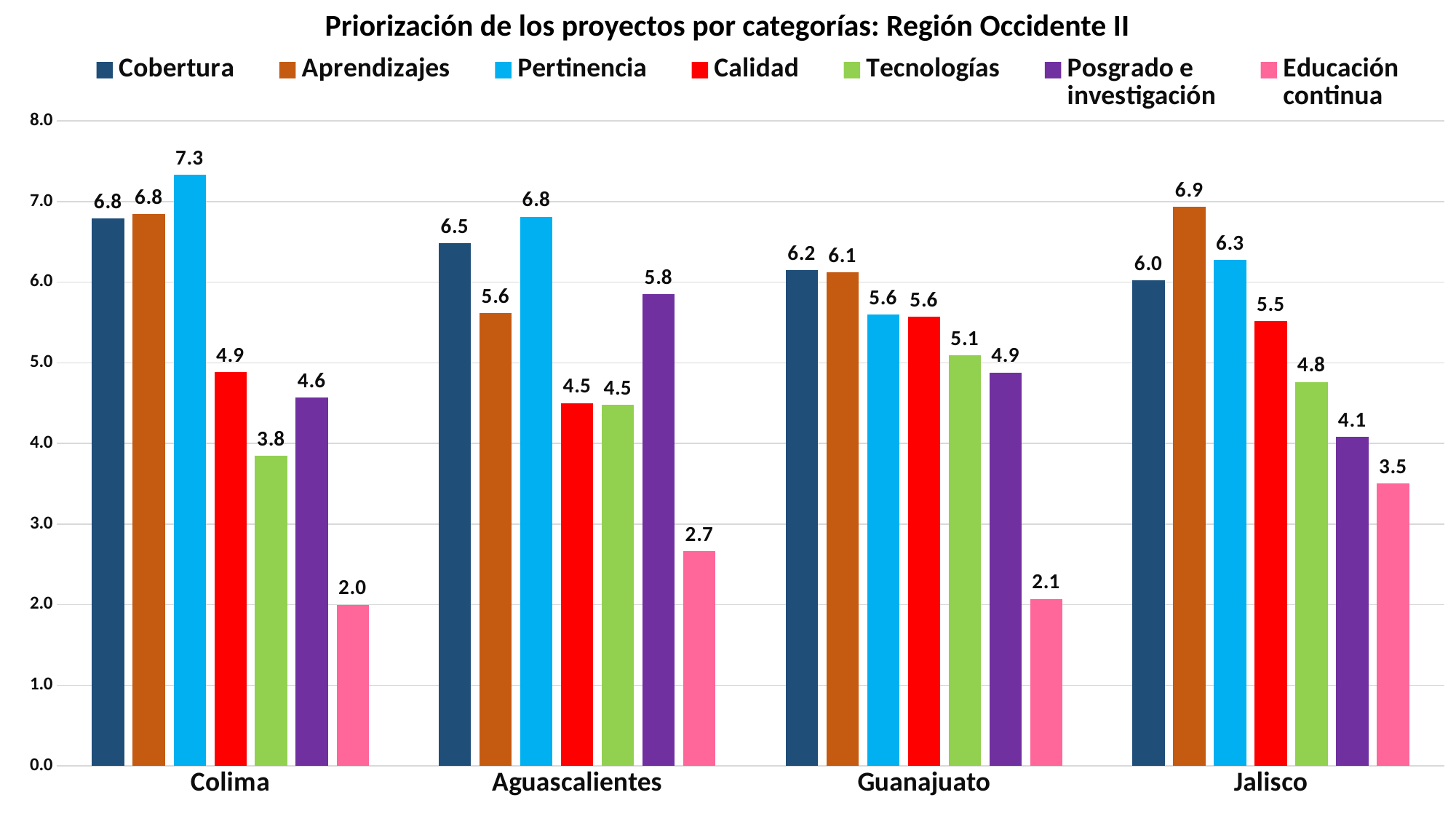
What is the difference between Pertinencia and Calidad in Aguascalientes? 2.3 Which category has the lowest value for Colima? Educación continua How many series does the legend list? 7 What is the value for Posgrado e investigación in Aguascalientes? 5.8 How many states are shown on the x axis? 4 Is the value for Cobertura in Guanajuato greater or less than 6.0? greater What is the title of the chart? Priorización de los proyectos por categorías: Región Occidente II Which category has the highest value for Jalisco? Aprendizajes Which is larger, Tecnologías in Guanajuato or Tecnologías in Jalisco? Tecnologías in Guanajuato What kind of chart is this? Bar chart What is the value for Educación continua in Guanajuato? 2.1 What is the value for Pertinencia in Colima? 7.3